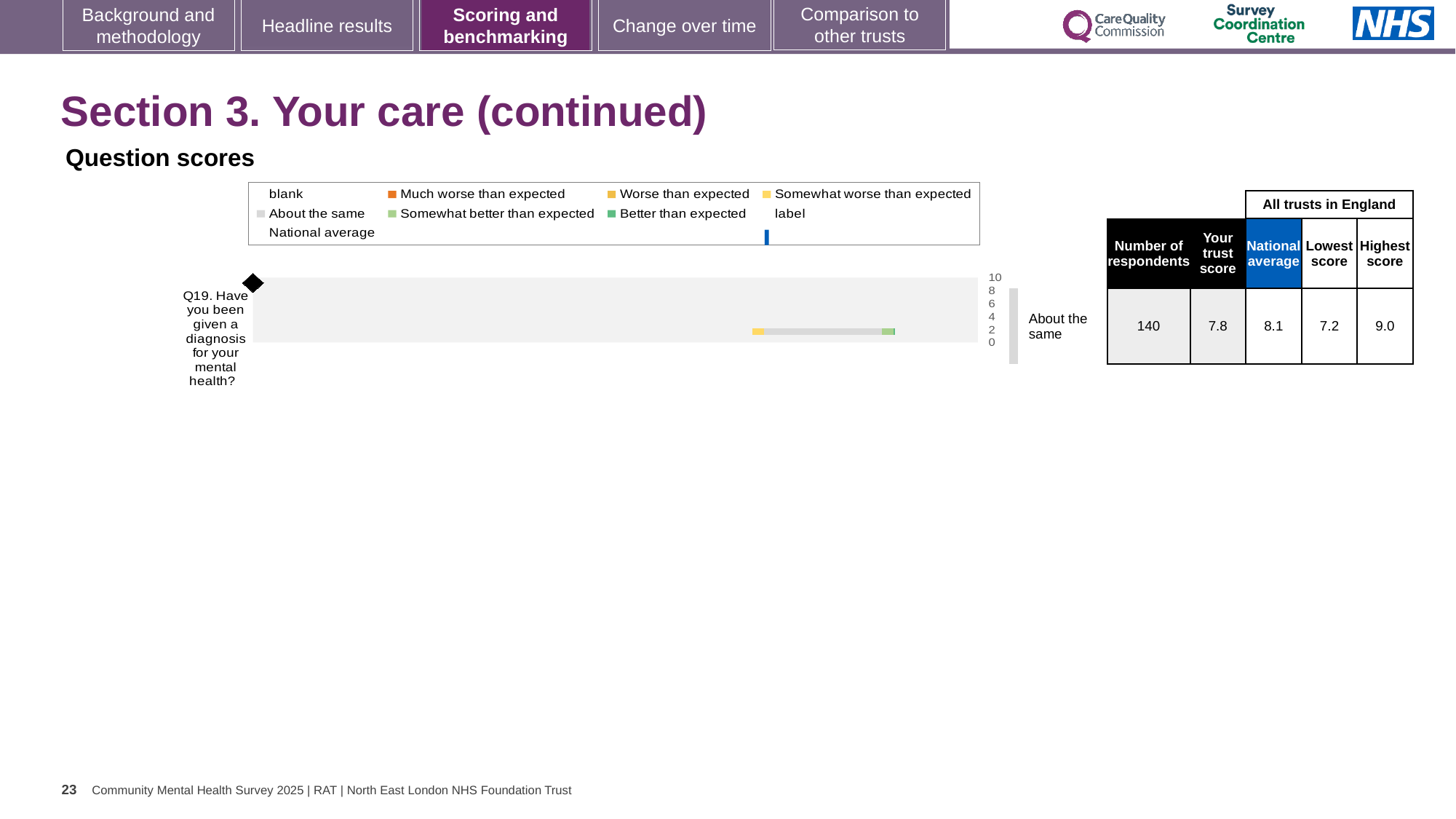
Which is larger for Q19, the trust score or the national average? National average What type of chart is used to show the Q19 question score? bar chart What is the difference between the highest and lowest scores for Q19 across all trusts in England? 1.8 What benchmark category is shown next to the Q19 bar? About the same By how much does the national average exceed the trust score for Q19? 0.3 How many respondents answered Q19? 140 What is the trust score for Q19 (Have you been given a diagnosis for your mental health?)? 7.8 Is the trust score for Q19 greater or less than 8? less What is the highest score among all trusts in England for Q19? 9.0 How many questions are plotted on the chart? 1 What is the lowest score among all trusts in England for Q19? 7.2 What is the national average score for Q19? 8.1